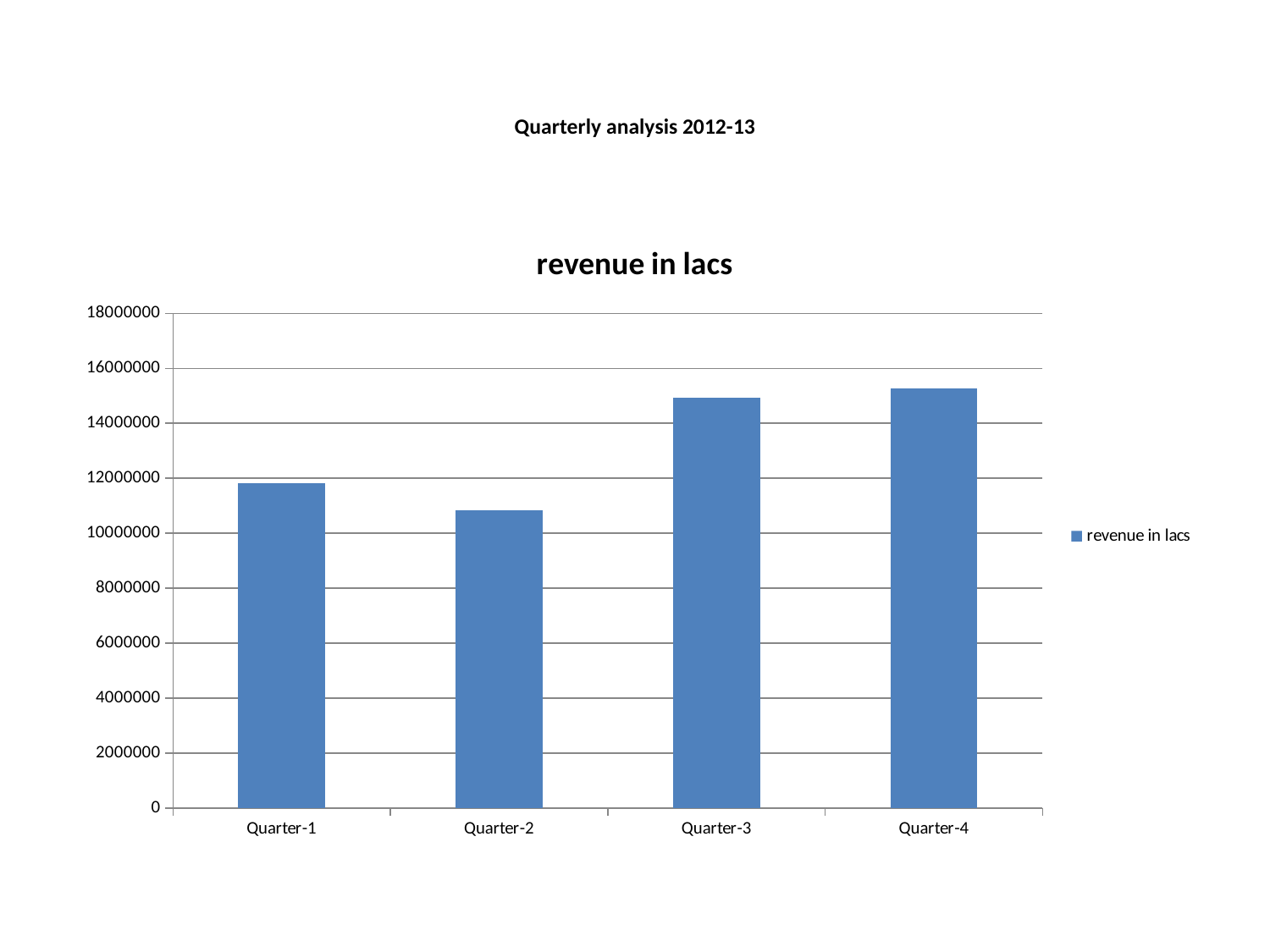
Is the value for Quarter-2 greater or less than 12000000? less Which is larger, the revenue for Quarter-2 or Quarter-3? Quarter-3 What is the title of the chart? revenue in lacs How many series does the legend list? 1 How many quarters are plotted on the chart? 4 Which is larger, the revenue for Quarter-1 or Quarter-2? Quarter-1 Which quarter has the lowest revenue? Quarter-2 Is the value for Quarter-3 greater or less than 14000000? greater Is the value for Quarter-1 greater or less than 10000000? greater What kind of chart is shown on the slide? bar chart What is the name of the series shown in the legend? revenue in lacs